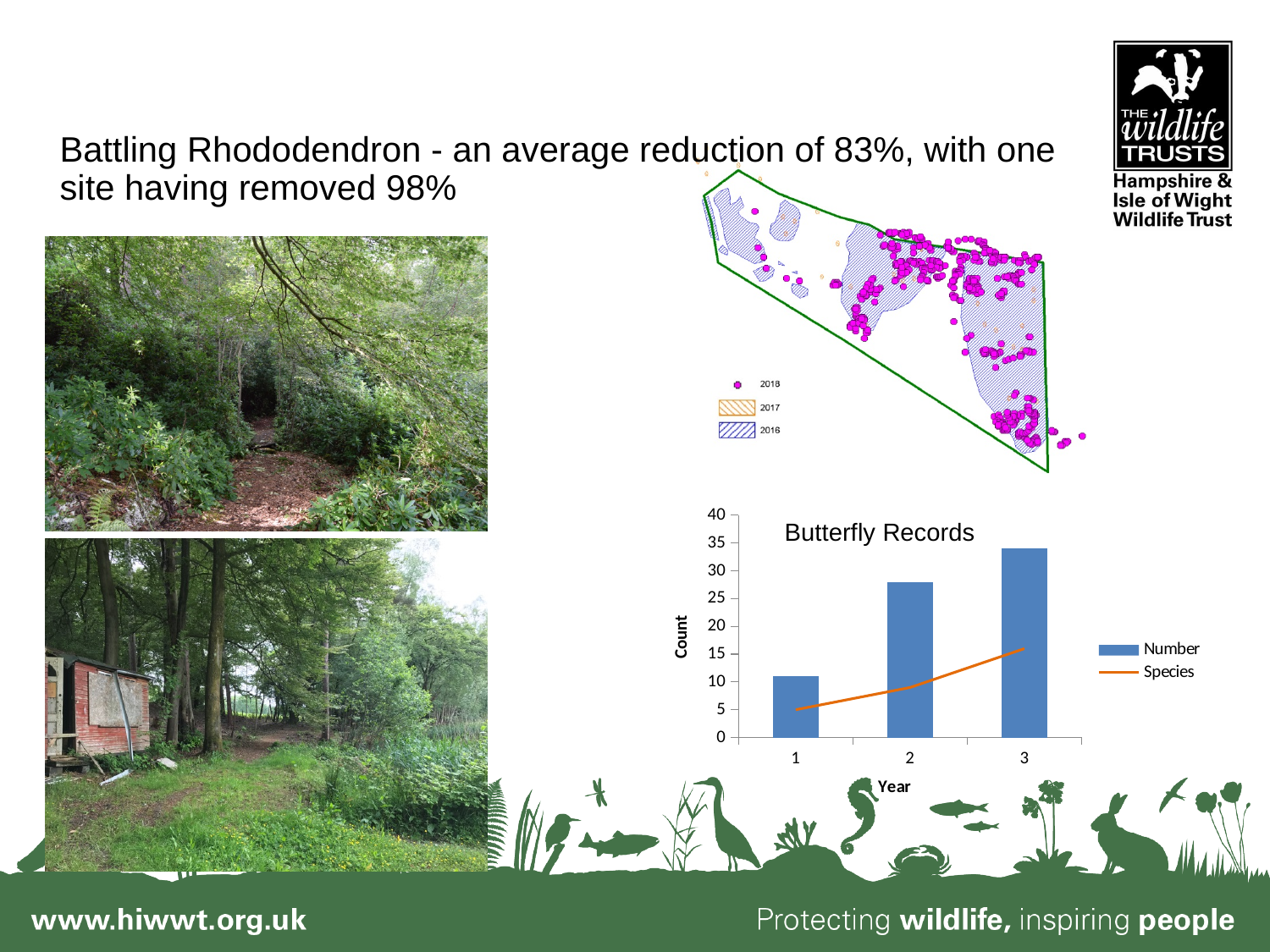
In the Butterfly Records chart, is the Number for year 1 greater or less than 15? less How many series does the legend of the Butterfly Records chart list? 2 In the Butterfly Records chart, is the Species value for year 1 greater or less than 10? less In the Butterfly Records chart, which year has the lowest Number? 1 In the Butterfly Records chart, which year has the highest Number? 3 In the Butterfly Records chart, is the Number for year 2 greater or less than 25? greater How many years are shown on the x axis of the Butterfly Records chart? 3 In the Butterfly Records chart, does the Species line rise or fall from year 1 to year 3? rise In the Butterfly Records chart, is the Number for year 2 larger or smaller than the Number for year 1? larger What type of chart is the Butterfly Records chart? bar chart with a line